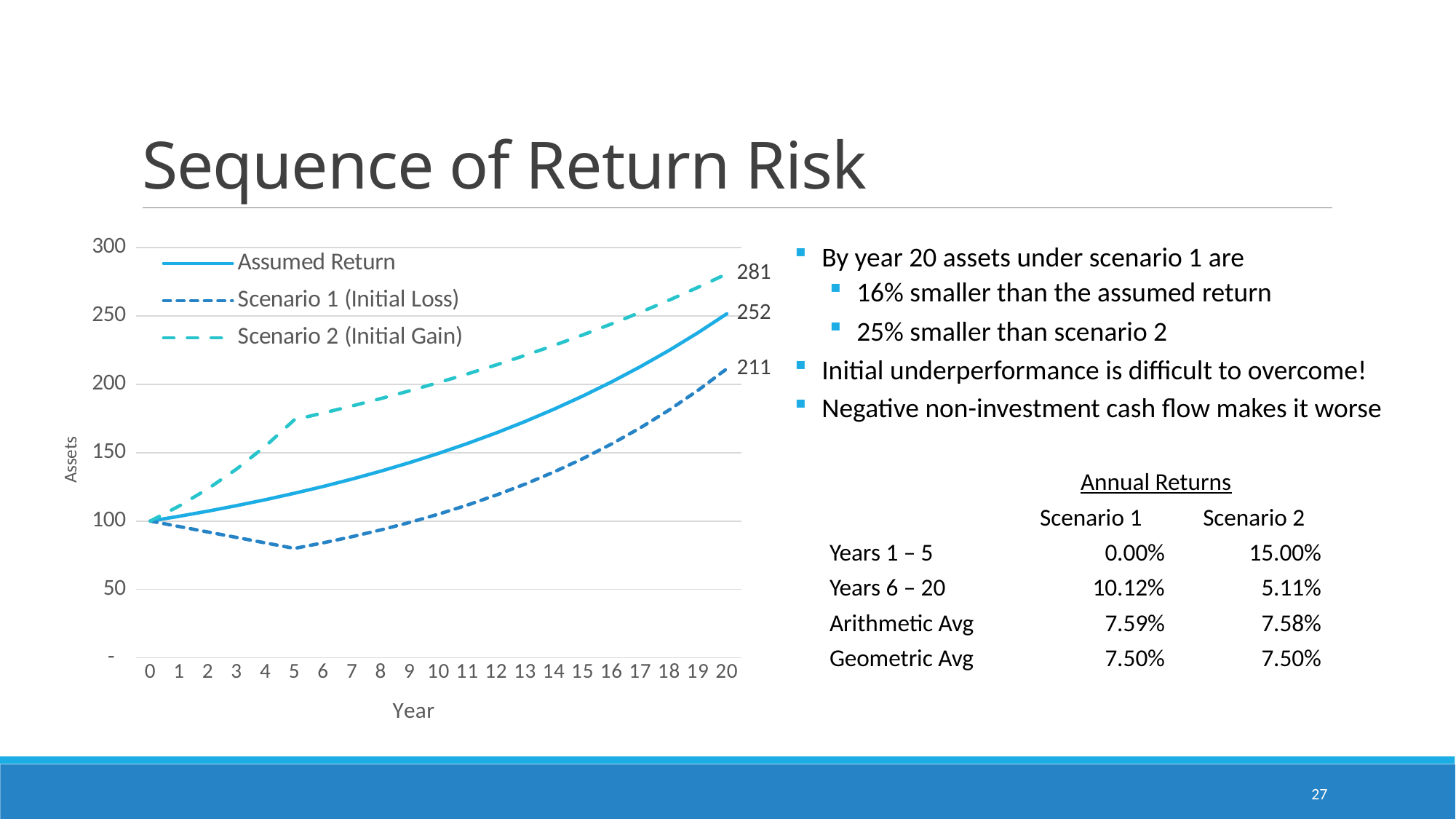
What is the difference between the year-20 values of the Assumed Return and Scenario 1 (Initial Loss)? 41 What is the value of Scenario 1 (Initial Loss) at year 20? 211 What is the value of the Assumed Return series at year 20? 252 What is the label of the y axis of the chart? Assets At year 20, is the value for Scenario 2 (Initial Gain) larger or smaller than the Assumed Return? larger What kind of chart is shown on the slide? line chart Which series has the highest value at year 20? Scenario 2 (Initial Gain) Which series has the lowest value at year 20? Scenario 1 (Initial Loss) What is the difference between the year-20 values of Scenario 2 (Initial Gain) and Scenario 1 (Initial Loss)? 70 How many series does the legend list? 3 What is the value of Scenario 2 (Initial Gain) at year 20? 281 Is the value for Scenario 1 (Initial Loss) at year 5 greater or less than 100? less